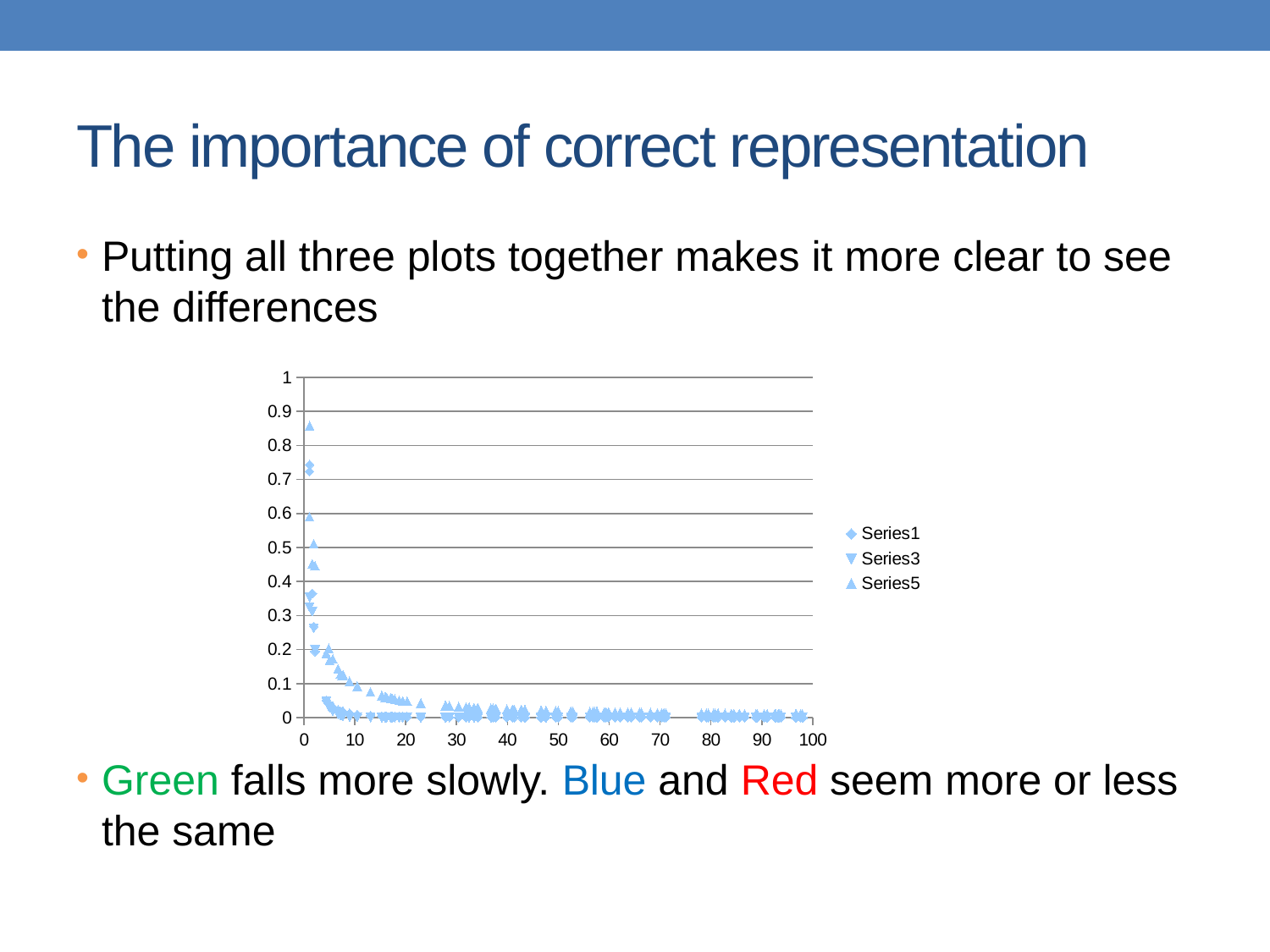
Do the plotted values rise or fall as the x axis increases? fall Which series reaches the highest value on the chart? Series5 Is the highest value for Series3 greater or less than 0.5? less Is the highest value for Series1 greater or less than 0.5? greater What are the names of the series listed in the chart's legend? Series1, Series3, Series5 Which series has the larger maximum value, Series5 or Series3? Series5 Are the values for Series5 at x = 90 greater or less than 0.1? less What is the highest tick value shown on the chart's y axis? 1 What kind of chart is shown on the slide? Scatter chart How many series does the chart's legend list? 3